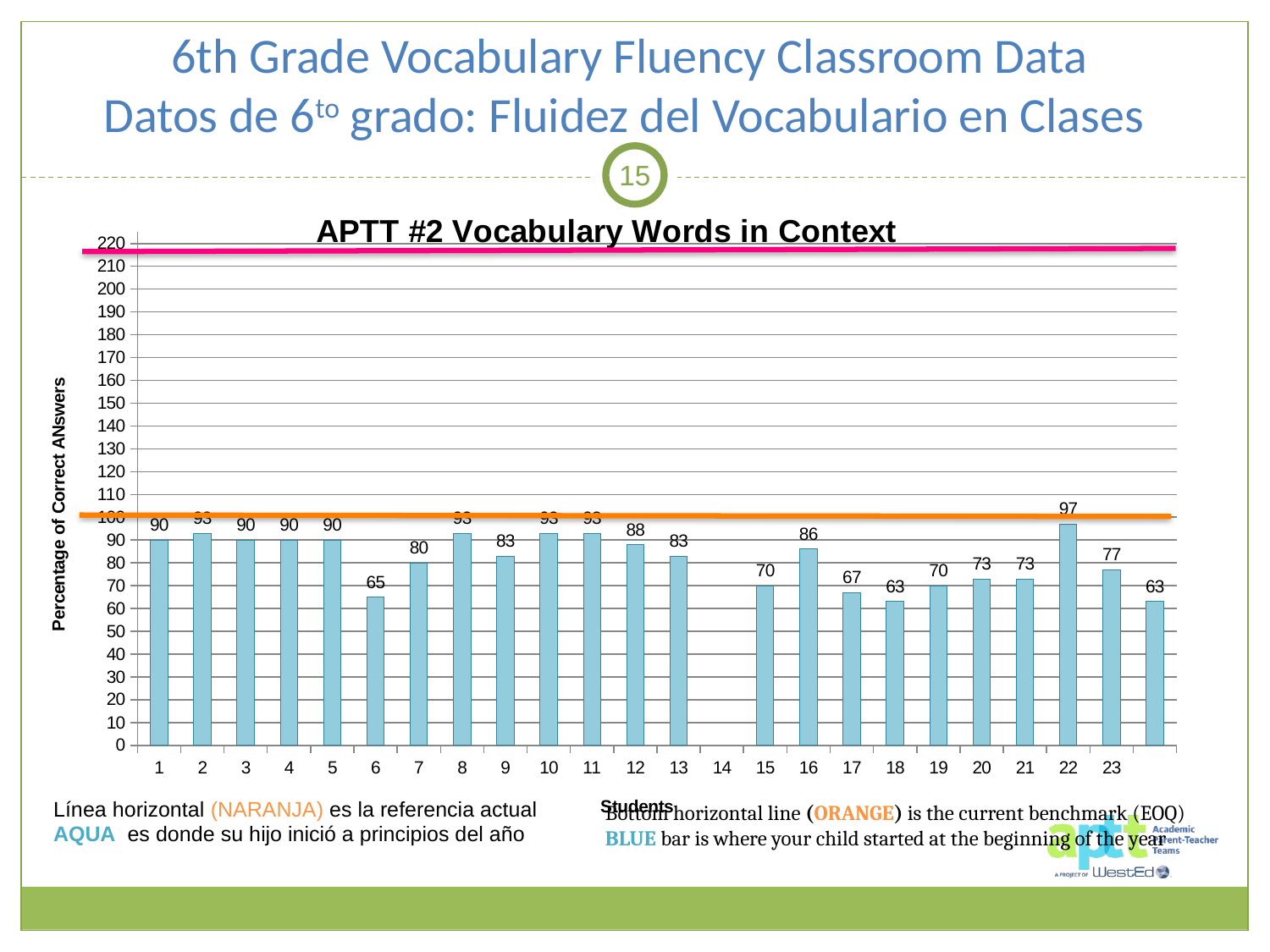
Which student has the highest value? 22 What is the value for student 6? 65 What is the difference between the values for student 22 and student 6? 32 Is the value for student 1 greater or less than 100? less How many student numbers are labeled on the x axis? 23 What is the difference between the values for student 12 and student 13? 5 Which has the larger value, student 16 or student 17? student 16 What is the value for student 22? 97 What is the value for student 12? 88 What kind of chart is shown on the slide? bar chart What is the title of the chart? APTT #2 Vocabulary Words in Context What is the value for student 23? 77